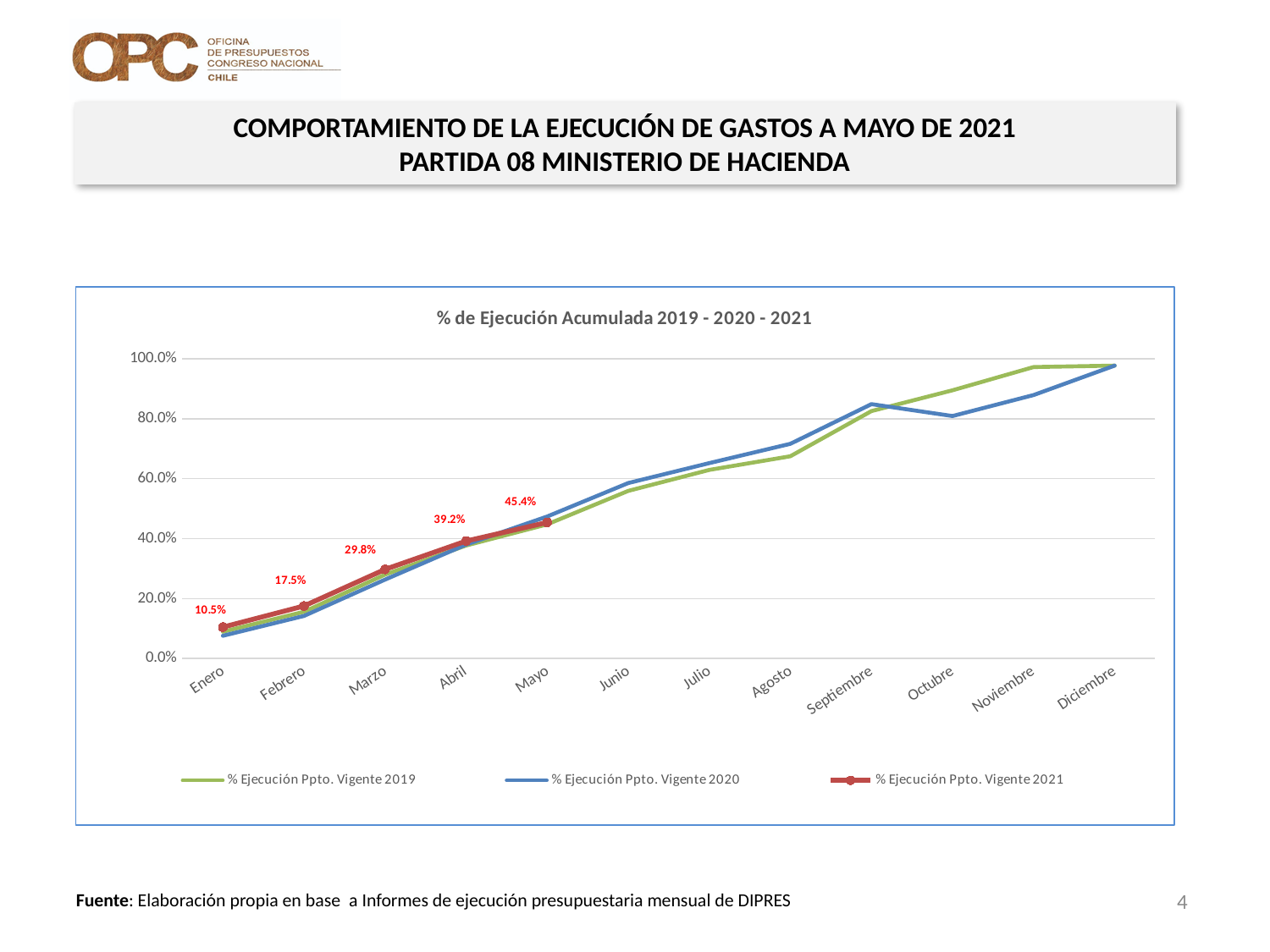
How many months are shown on the x axis of the chart? 12 Which month has the lowest value in the % Ejecución Ppto. Vigente 2021 series? Enero What is the value for Marzo in the % Ejecución Ppto. Vigente 2021 series? 29.8% What is the value for Enero in the % Ejecución Ppto. Vigente 2021 series? 10.5% What kind of chart is shown on the slide? Line chart Is the value for Noviembre in the % Ejecución Ppto. Vigente 2019 series greater or less than 80.0%? greater How many series does the chart's legend list? 3 Which month has the highest value in the % Ejecución Ppto. Vigente 2021 series? Mayo What is the value for Mayo in the % Ejecución Ppto. Vigente 2021 series? 45.4% Is the value for Agosto in the % Ejecución Ppto. Vigente 2019 series greater or less than 80.0%? less Do the values in the % Ejecución Ppto. Vigente 2021 series rise or fall from Enero to Mayo? Rise What is the difference between the Mayo and Abril values in the % Ejecución Ppto. Vigente 2021 series? 6.2 percentage points